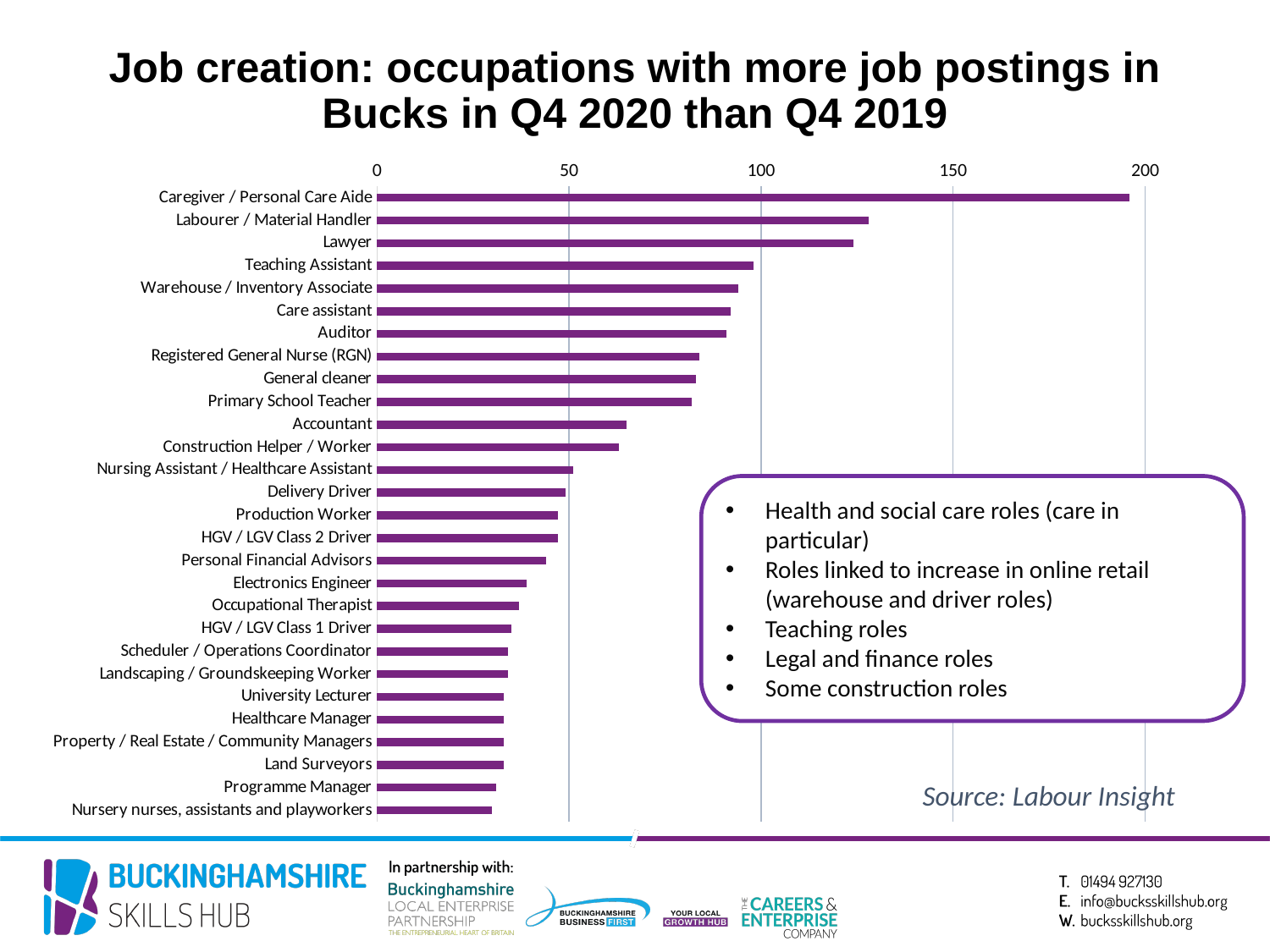
Is the value for Accountant greater or less than 50? greater Is the value for Lawyer greater or less than 100? greater Which has a higher value, Accountant or Electronics Engineer? Accountant Is the value for Labourer / Material Handler greater or less than 100? greater How many occupations are listed in the chart? 28 Which occupation has the highest number of job postings in the chart? Caregiver / Personal Care Aide Which has a higher value, Caregiver / Personal Care Aide or Lawyer? Caregiver / Personal Care Aide What is the source cited for the chart data? Labour Insight What kind of chart is shown on the slide? Bar chart